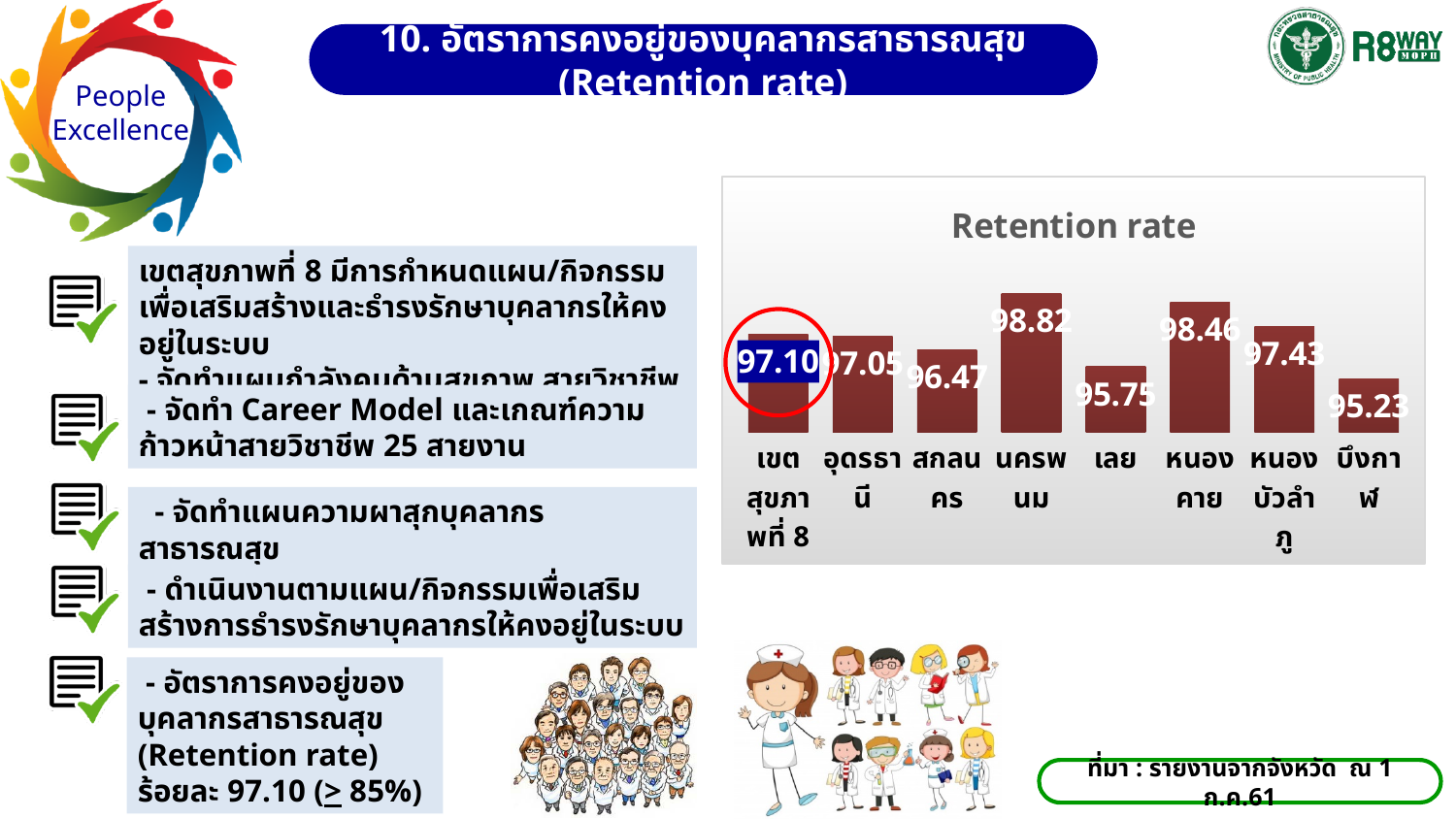
What is the Retention rate value for นครพนม? 98.82 Which category has the lowest Retention rate in the chart? บึงกาฬ Which province has the highest Retention rate in the chart? นครพนม Which has a higher Retention rate, เลย or สกลนคร? สกลนคร How many categories are shown in the Retention rate chart? 8 What is the difference between the Retention rate of หนองบัวลำภู and อุดรธานี? 0.38 What is the title of the chart on the slide? Retention rate What is the Retention rate value for หนองคาย? 98.46 What is the Retention rate value for เขตสุขภาพที่ 8? 97.10 What is the Retention rate value for บึงกาฬ? 95.23 What is the difference between the Retention rate of นครพนม and บึงกาฬ? 3.59 What type of chart is used to show the Retention rate? Bar chart